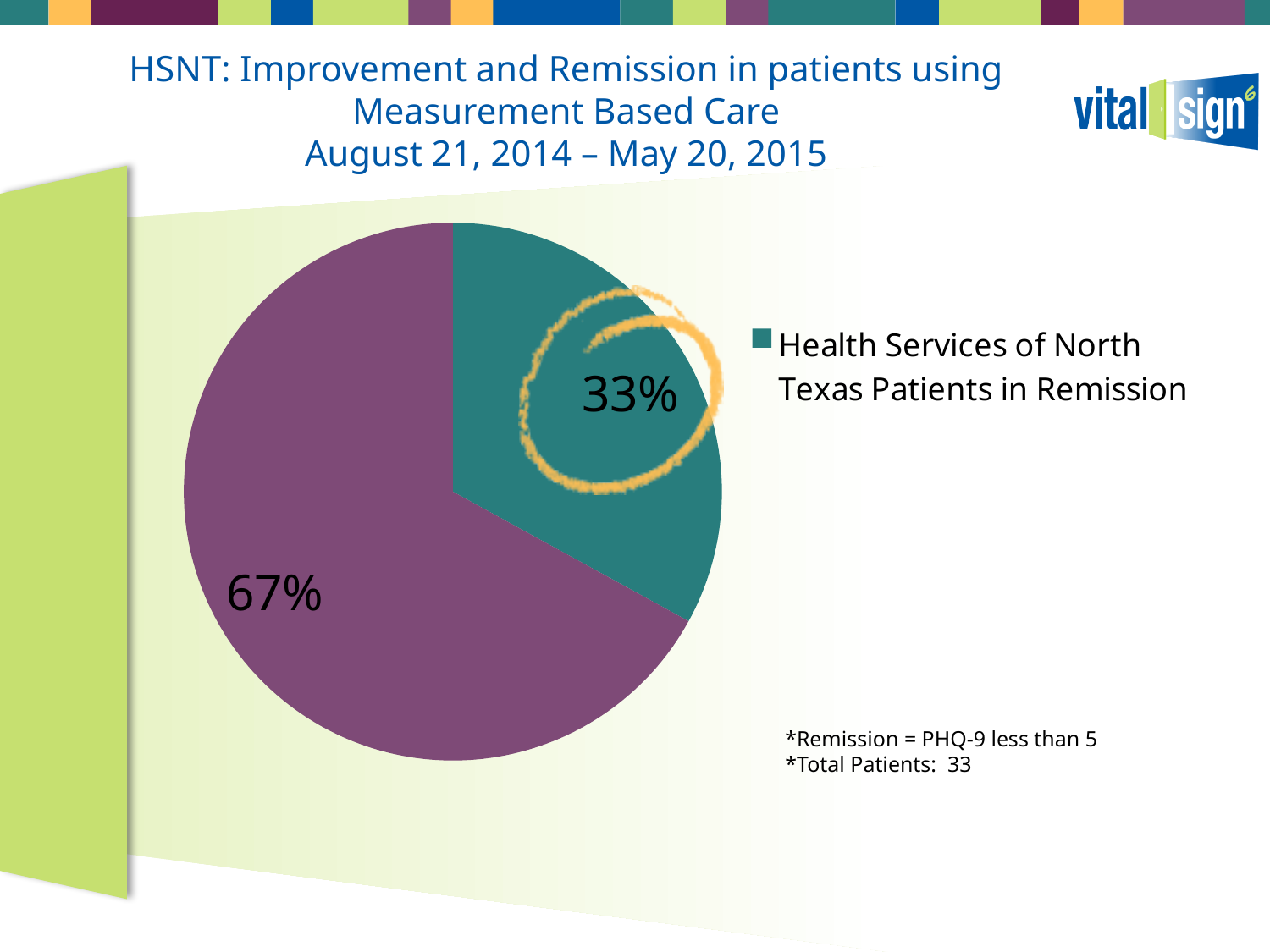
What kind of chart is shown on the slide? pie chart How many slices does the pie chart have? 2 Is the share of patients in remission greater or less than 50%? less How many entries does the legend list? 1 What percentage is shown on the teal slice of the pie chart? 33% What is the difference in percentage points between the purple slice and the teal slice? 34 Which slice is larger, the purple slice or the teal slice? the purple slice What share of the pie is labelled for Health Services of North Texas Patients in Remission? 33% According to the note on the slide, what is the total number of patients? 33 What is the legend entry shown next to the teal square? Health Services of North Texas Patients in Remission What percentage is shown on the purple slice of the pie chart? 67% What colour is the slice representing patients in remission? teal